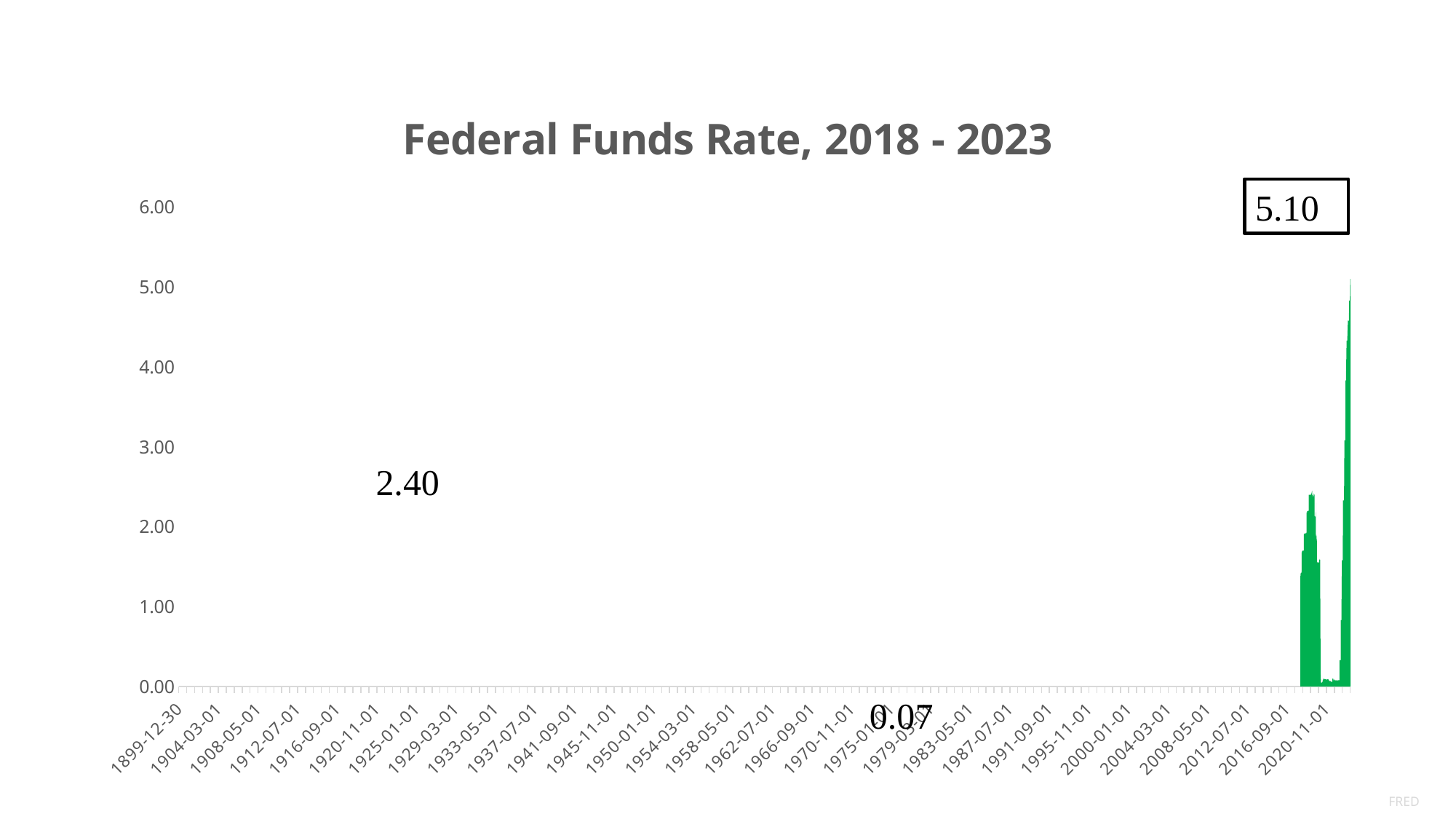
Do the plotted values rise or fall at the far right end of the chart? rise What is the lowest value labelled on the chart? 0.07 Is the highest peak of the plotted data greater or less than 4.00? greater Is the earlier, smaller peak of the plotted data (around 2019) greater or less than 3.00? less What value is shown in the boxed label at the top right of the chart? 5.10 What kind of chart is shown on the slide? bar chart What is the title of the chart? Federal Funds Rate, 2018 - 2023 Which labelled value is larger, 2.40 or 0.07? 2.40 What is the highest tick value shown on the y axis? 6.00 Which peak is higher, the earlier peak around 2019 or the later peak around 2023? the later peak around 2023 What is the highest value labelled on the chart? 5.10 What is the difference between the labelled values 5.10 and 2.40? 2.70